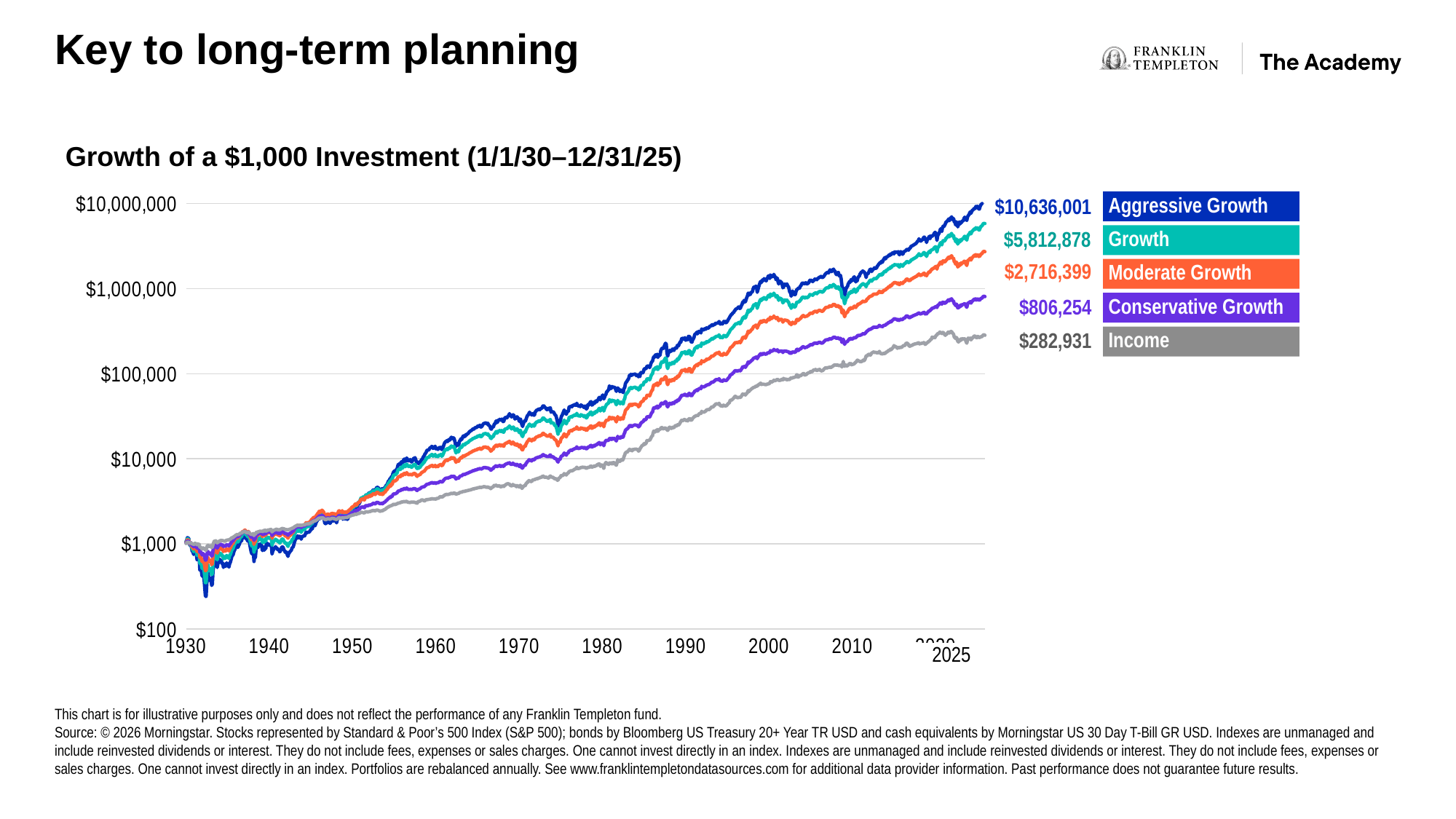
What kind of chart is shown on the slide? Line chart How many portfolio series are shown in the legend? 5 What is the title of the chart? Growth of a $1,000 Investment (1/1/30–12/31/25) What is the ending value shown for the Moderate Growth portfolio? $2,716,399 Which has a larger ending value, Growth or Moderate Growth? Growth What is the difference between the ending values of the Conservative Growth and Income portfolios? $523,323 Is the value of the Aggressive Growth line in 2000 greater or less than $1,000,000? greater Which portfolio has the lowest ending value? Income What is the ending value shown for the Aggressive Growth portfolio? $10,636,001 What is the ending value shown for the Income portfolio? $282,931 What is the difference between the ending values of the Aggressive Growth and Growth portfolios? $4,823,123 Which portfolio has the highest ending value? Aggressive Growth